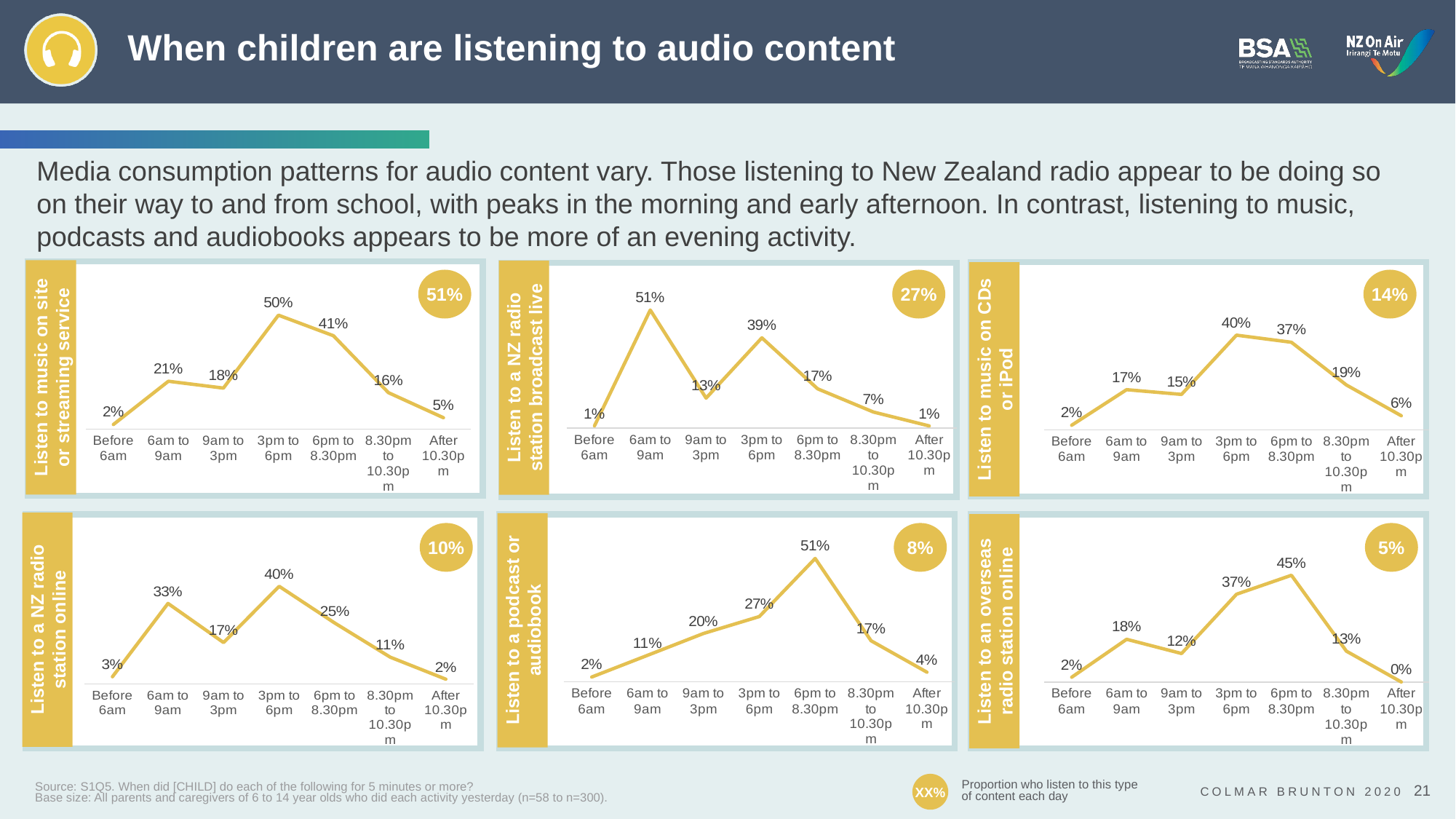
What proportion is shown in the circle badge on the 'Listen to music on site or streaming service' chart? 51% In the 'Listen to an overseas radio station online' chart, which is larger: the value for 3pm to 6pm or the value for 6pm to 8.30pm? 6pm to 8.30pm In the 'Listen to an overseas radio station online' chart, what is the value for After 10.30pm? 0% In the 'Listen to music on site or streaming service' chart, what is the value for 3pm to 6pm? 50% In the 'Listen to a NZ radio station broadcast live' chart, which time slot has the highest value? 6am to 9am In the 'Listen to a NZ radio station online' chart, what is the value for 6am to 9am? 33% In the 'Listen to a NZ radio station online' chart, which time slot has the lowest value? After 10.30pm How many time slots are plotted on the x axis of the 'Listen to a podcast or audiobook' chart? 7 In the 'Listen to a podcast or audiobook' chart, what is the value for 6pm to 8.30pm? 51% What type of chart is used for 'Listen to a NZ radio station broadcast live'? Line chart In the 'Listen to a podcast or audiobook' chart, do the values rise or fall from Before 6am to 6pm to 8.30pm? Rise In the 'Listen to music on CDs or iPod' chart, what is the difference between the 3pm to 6pm value and the 6pm to 8.30pm value? 3%